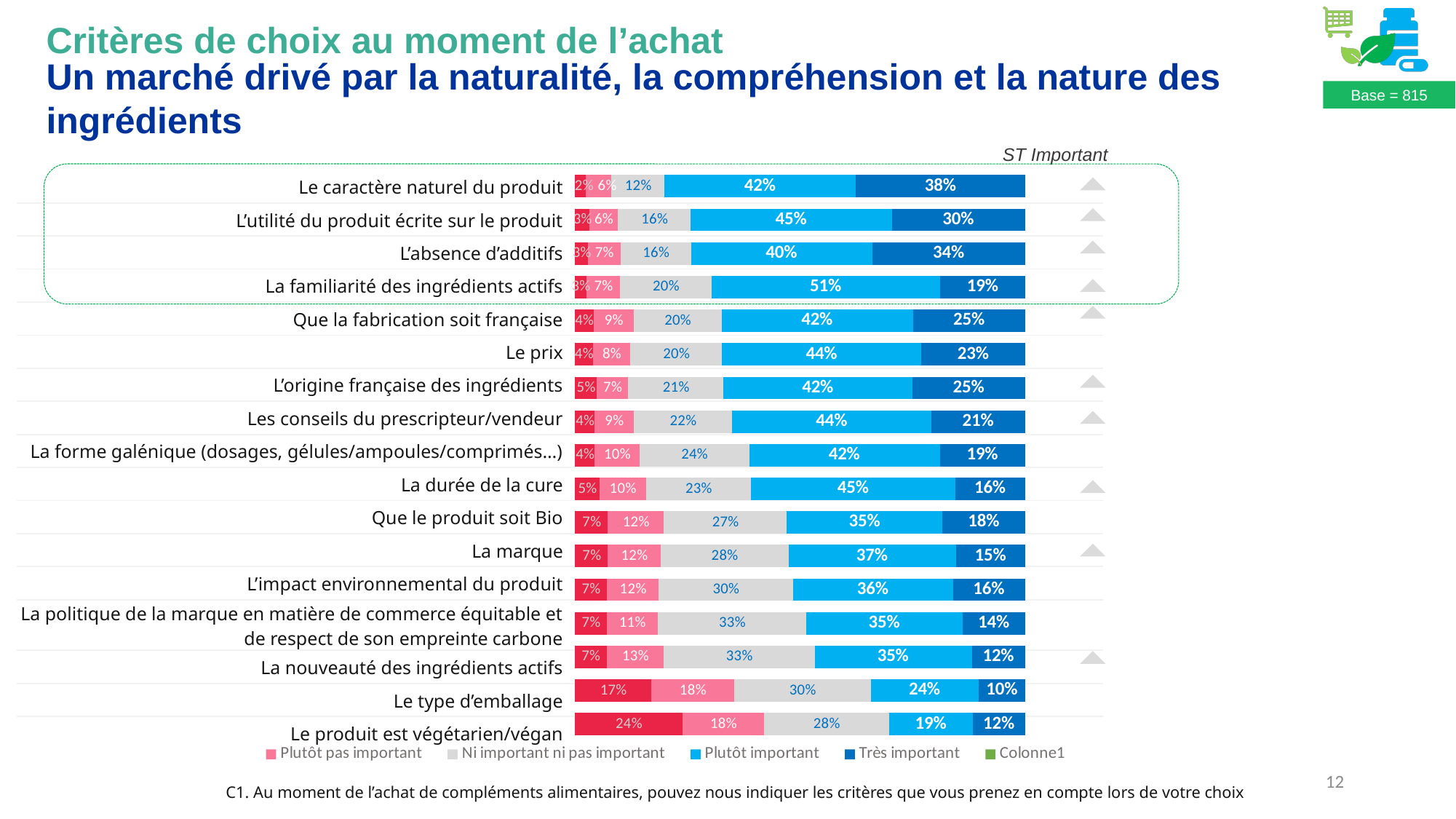
Which criterion has the highest 'Très important' percentage? Le caractère naturel du produit What type of chart is shown on the slide? Stacked bar chart Which has a higher 'Plutôt important' value: 'Le prix' or 'Que le produit soit Bio'? Le prix What is the 'Ni important ni pas important' value for 'Le type d'emballage'? 30% What is the base (sample size) indicated on the slide? Base = 815 What is the difference in 'Très important' percentage between 'Le caractère naturel du produit' and 'L'utilité du produit écrite sur le produit'? 8 percentage points Which criterion has the lowest 'Plutôt important' percentage? Le produit est végétarien/végan What is the combined 'Plutôt important' and 'Très important' percentage for 'L'absence d'additifs'? 74% What percentage of respondents rated 'Le caractère naturel du produit' as 'Très important'? 38% How many entries does the chart legend list? 5 How many criteria (bars) are shown in the chart? 17 What is the 'Plutôt important' value for 'La familiarité des ingrédients actifs'? 51%